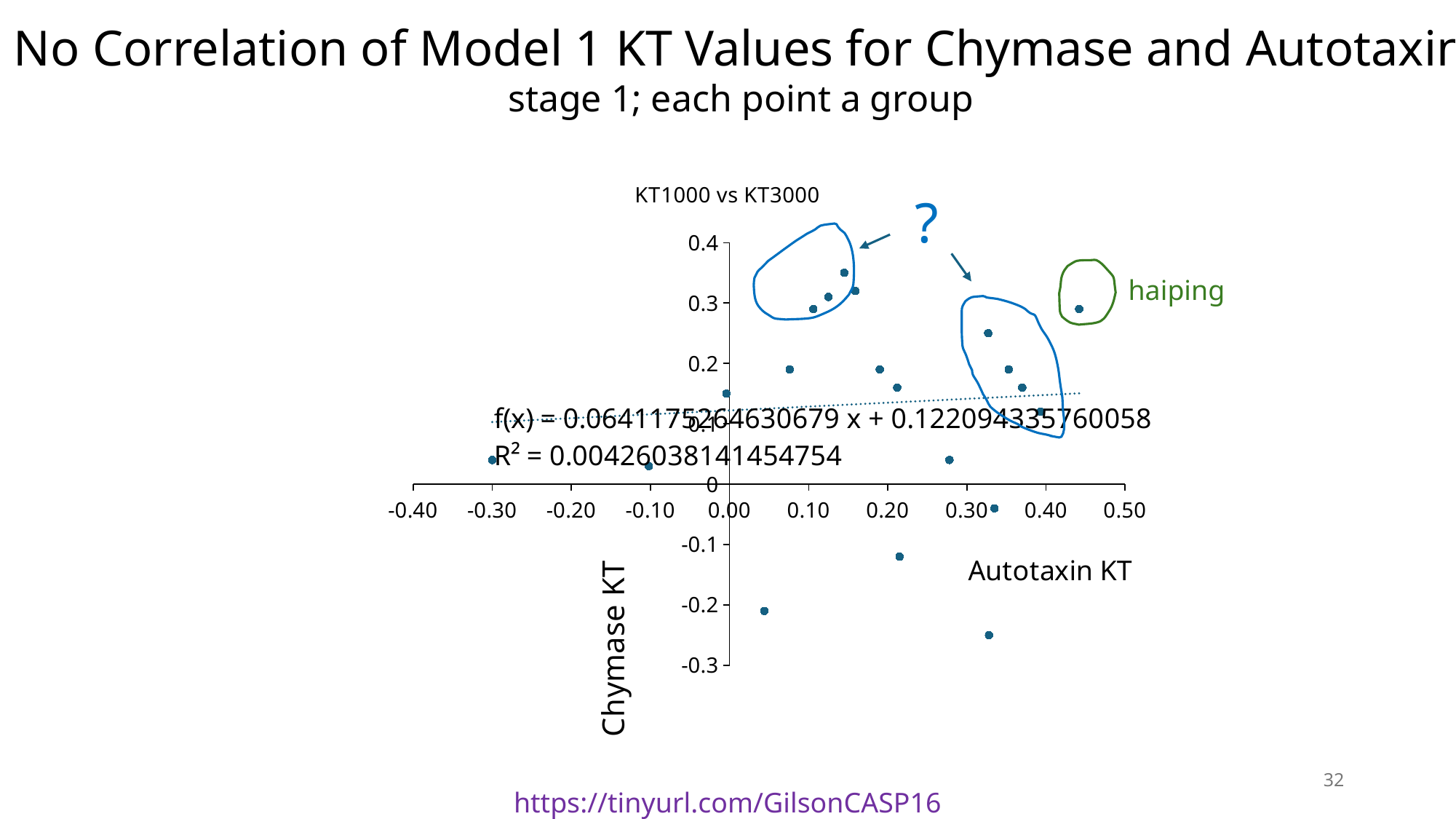
What kind of chart is shown on the slide? scatter chart Is the Chymase KT value of the highest point on the chart greater or less than 0.3? greater Is the Autotaxin KT value of the point labelled "haiping" greater or less than 0.40? greater Is the Chymase KT value of the lowest point on the chart greater or less than -0.2? less Does the dotted trendline rise or fall as Autotaxin KT increases? rise What is the title printed above the chart? KT1000 vs KT3000 Which has the higher Chymase KT value: the point labelled "haiping" or the highest point in the upper-left circled cluster? the highest point in the upper-left circled cluster What are the x-axis and y-axis labels of the chart? Autotaxin KT (x) and Chymase KT (y) What R² value is printed on the chart? R² = 0.00426038141454754 What is the trendline equation printed on the chart? f(x) = 0.0641175264630679 x + 0.122094335760058